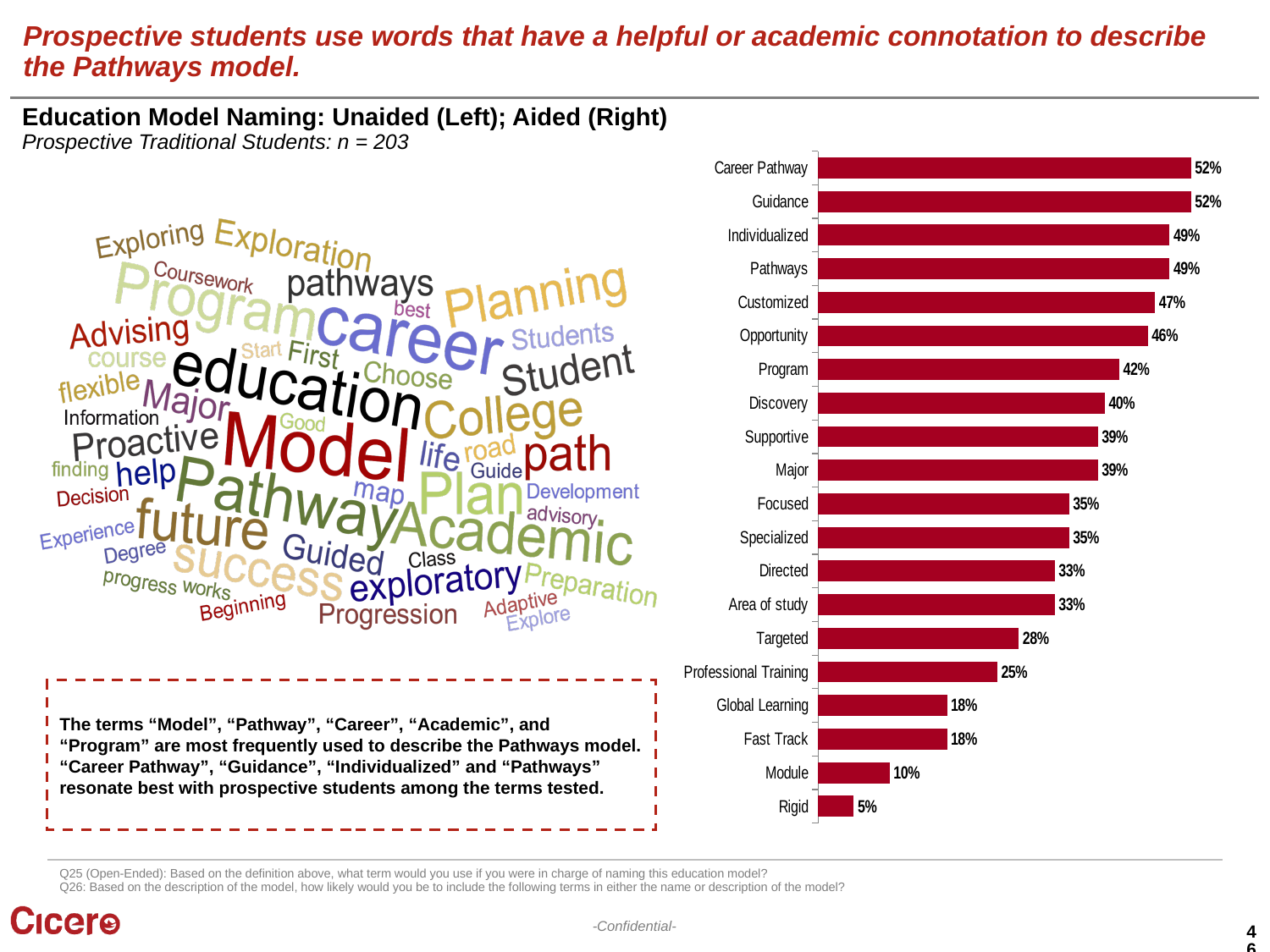
How many terms are listed in the bar chart on the right? 20 In the bar chart on the right, which has a higher value, Opportunity or Discovery? Opportunity What type of chart is shown on the right side of the slide? Bar chart In the bar chart on the right, what is the difference between the values for Program and Targeted? 14% In the bar chart on the right, do the values increase or decrease going from the top bar to the bottom bar? Decrease In the bar chart on the right, what is the difference between the values for Career Pathway and Rigid? 47% In the bar chart on the right, what percentage is shown for Customized? 47% In the bar chart on the right, which has a higher value, Fast Track or Directed? Directed What is the sample size (n) stated for the prospective traditional students in the chart subtitle? 203 In the bar chart on the right, which term has the lowest value? Rigid In the bar chart on the right, what percentage is shown for Module? 10% In the bar chart on the right, what is the value for Professional Training? 25%